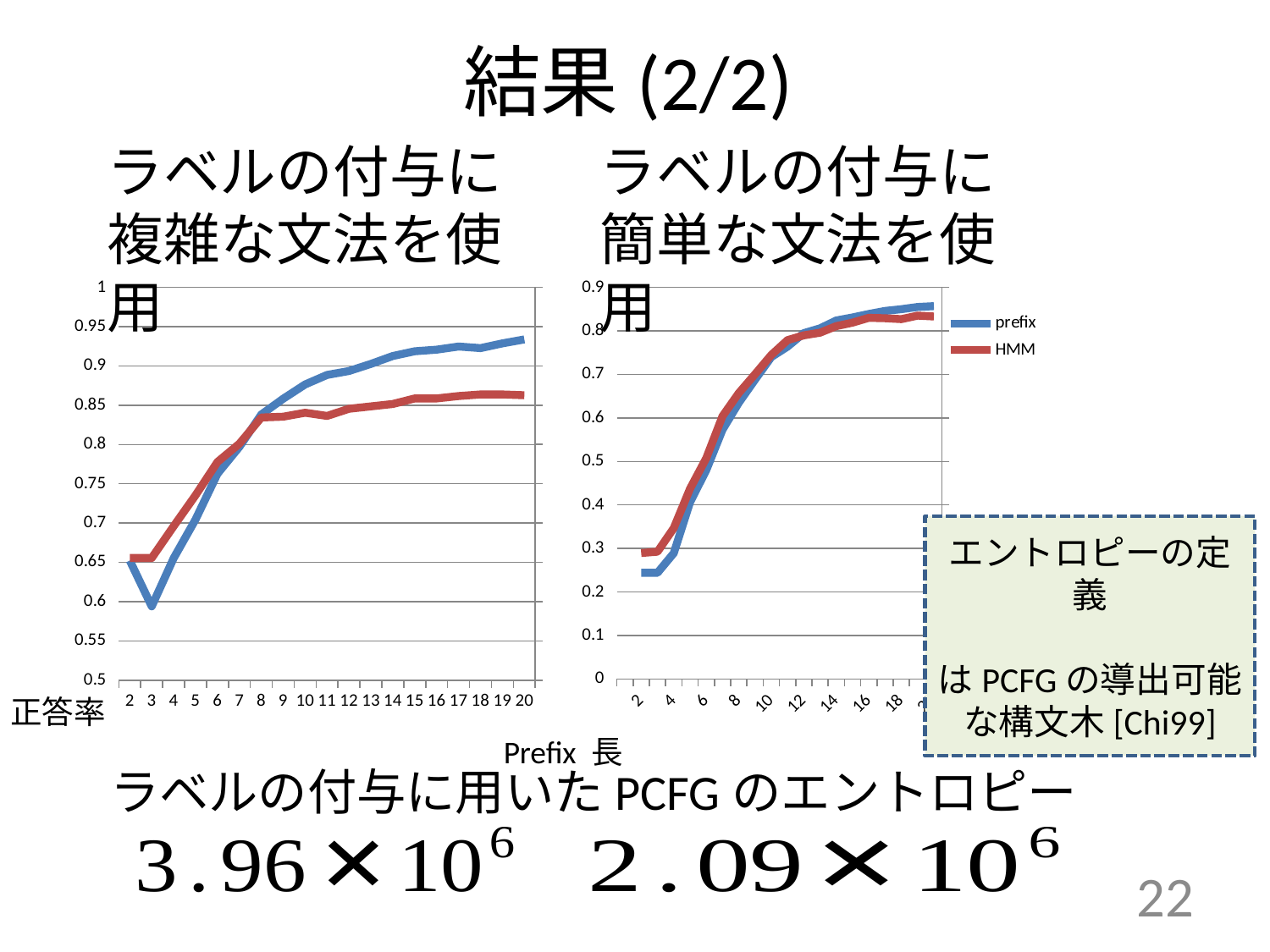
What kind of chart is the left chart (ラベルの付与に複雑な文法を使用)? line chart In the right chart, is the value of the prefix series at prefix length 20 greater or less than 0.8? greater In the right chart (ラベルの付与に簡単な文法を使用), is the value of the prefix series at prefix length 2 greater or less than 0.3? less What are the two series named in the legend of the right chart? prefix, HMM In the left chart, which series has the higher value at prefix length 20, prefix or HMM? prefix How many series does the legend on the right chart list? 2 In the right chart, do the values of the prefix series generally rise or fall as prefix length increases? rise How many x-axis categories (prefix lengths) are shown on the left chart? 19 In the left chart, is the value of the HMM series at prefix length 20 greater or less than 0.9? less In the left chart, which series has the higher value at prefix length 3, prefix or HMM? HMM